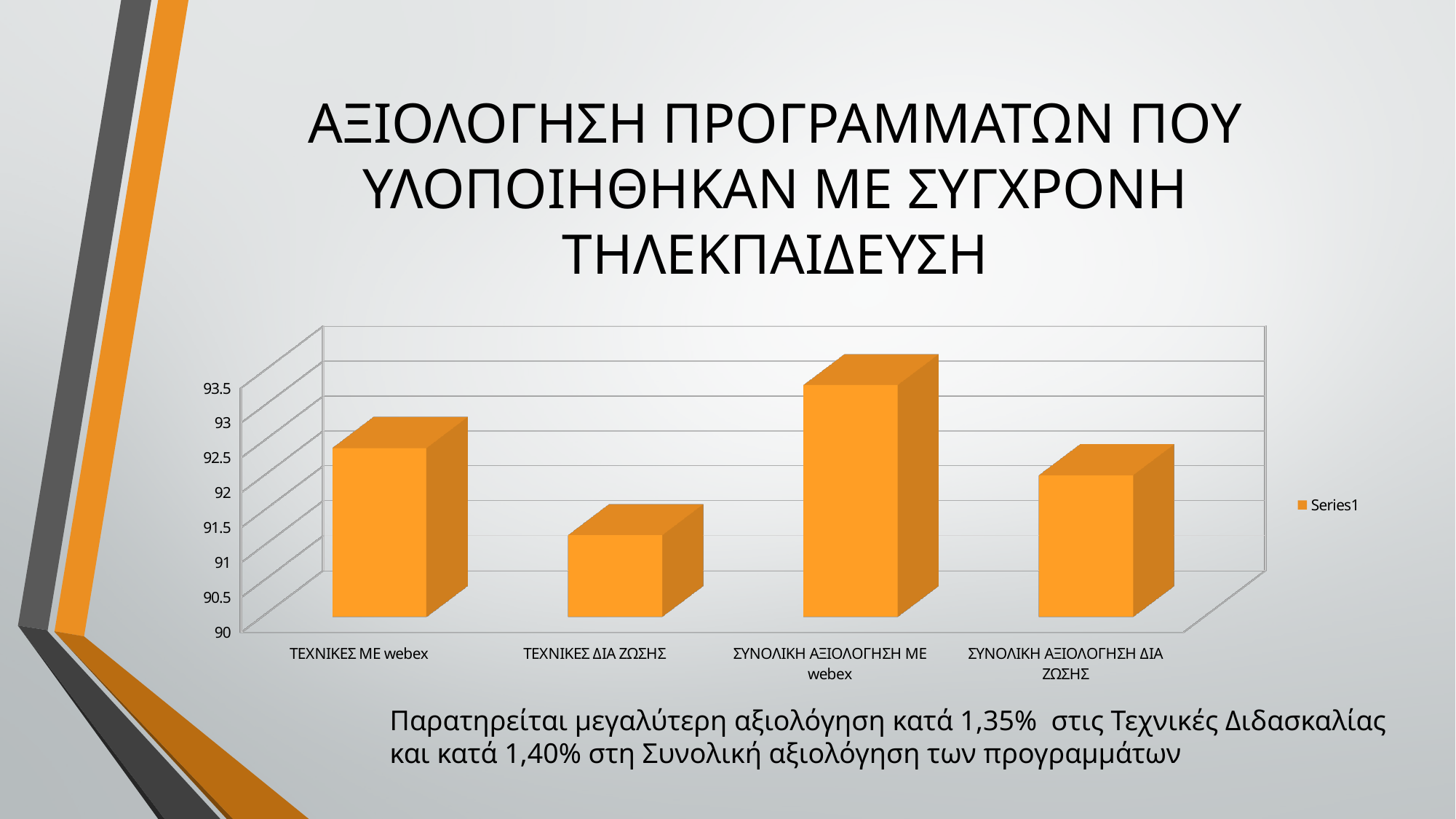
Is the value for ΣΥΝΟΛΙΚΗ ΑΞΙΟΛΟΓΗΣΗ ΜΕ webex greater or less than 93? greater Which category has the lowest bar? ΤΕΧΝΙΚΕΣ ΔΙΑ ΖΩΣΗΣ Is the value for ΤΕΧΝΙΚΕΣ ΔΙΑ ΖΩΣΗΣ greater or less than 92? less Which is larger, the value for ΣΥΝΟΛΙΚΗ ΑΞΙΟΛΟΓΗΣΗ ΜΕ webex or for ΣΥΝΟΛΙΚΗ ΑΞΙΟΛΟΓΗΣΗ ΔΙΑ ΖΩΣΗΣ? ΣΥΝΟΛΙΚΗ ΑΞΙΟΛΟΓΗΣΗ ΜΕ webex Which is larger, the value for ΤΕΧΝΙΚΕΣ ΜΕ webex or for ΤΕΧΝΙΚΕΣ ΔΙΑ ΖΩΣΗΣ? ΤΕΧΝΙΚΕΣ ΜΕ webex What kind of chart is shown on the slide? Bar chart What colour are the bars in the chart? Orange Is the value for ΤΕΧΝΙΚΕΣ ΜΕ webex greater or less than 92? greater How many categories are plotted on the chart? 4 What is the name of the series shown in the chart legend? Series1 Which category has the highest bar? ΣΥΝΟΛΙΚΗ ΑΞΙΟΛΟΓΗΣΗ ΜΕ webex How many series does the chart legend list? 1